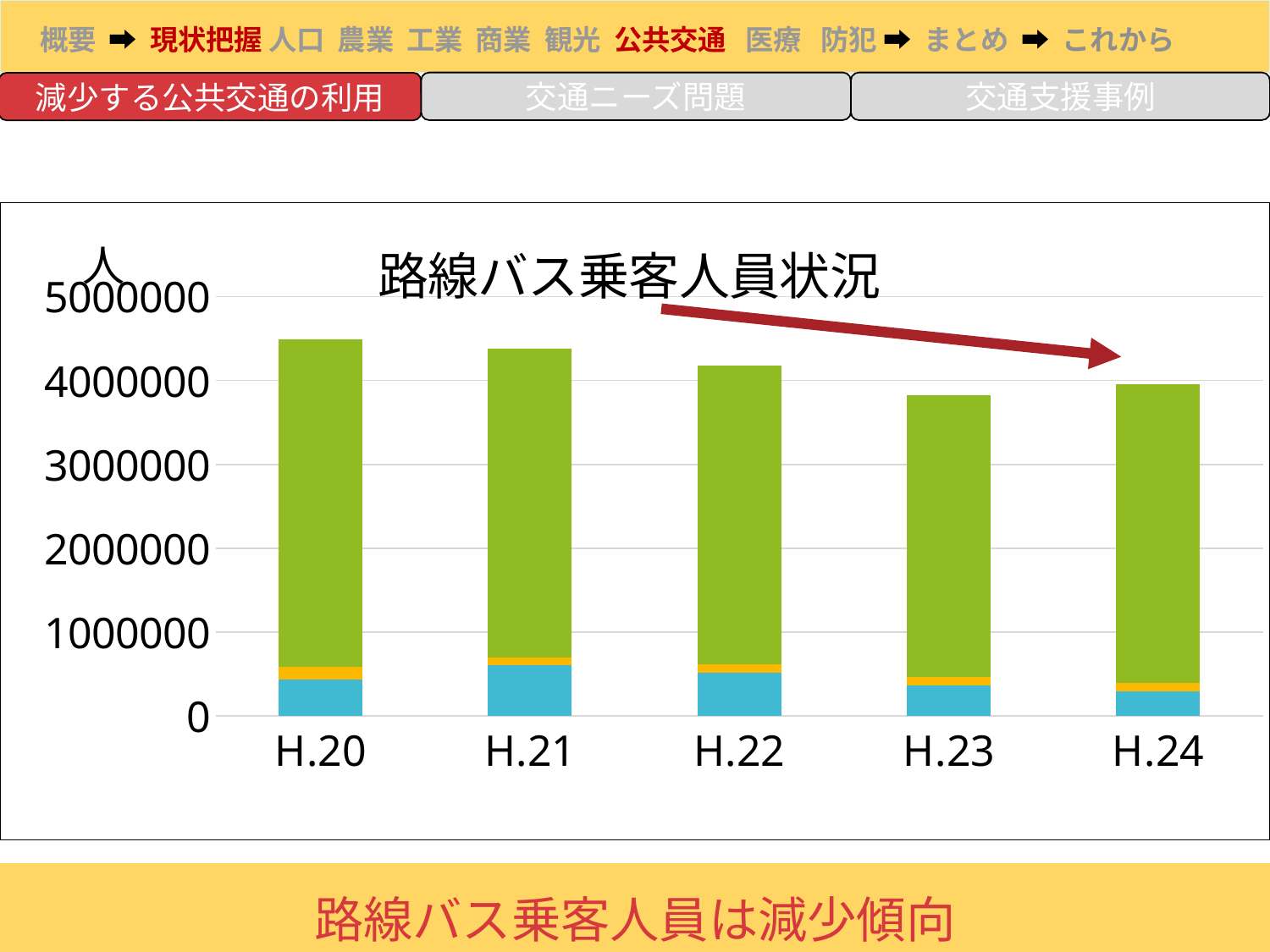
What kind of chart is shown on the slide? bar chart What is the title of the chart? 路線バス乗客人員状況 Which bar is taller, H.20 or H.23? H.20 Is the total bar value for H.23 greater or less than 4000000? less What is the highest tick value shown on the y axis? 5000000 Which year has the shortest bar? H.23 Is the total bar value for H.20 greater or less than 4000000? greater Which year has the tallest bar? H.20 Do the bar totals generally rise or fall from H.20 to H.24? fall Which bar is taller, H.22 or H.24? H.22 How many categories (years) are shown on the x axis? 5 Is the total bar value for H.22 greater or less than 4000000? greater